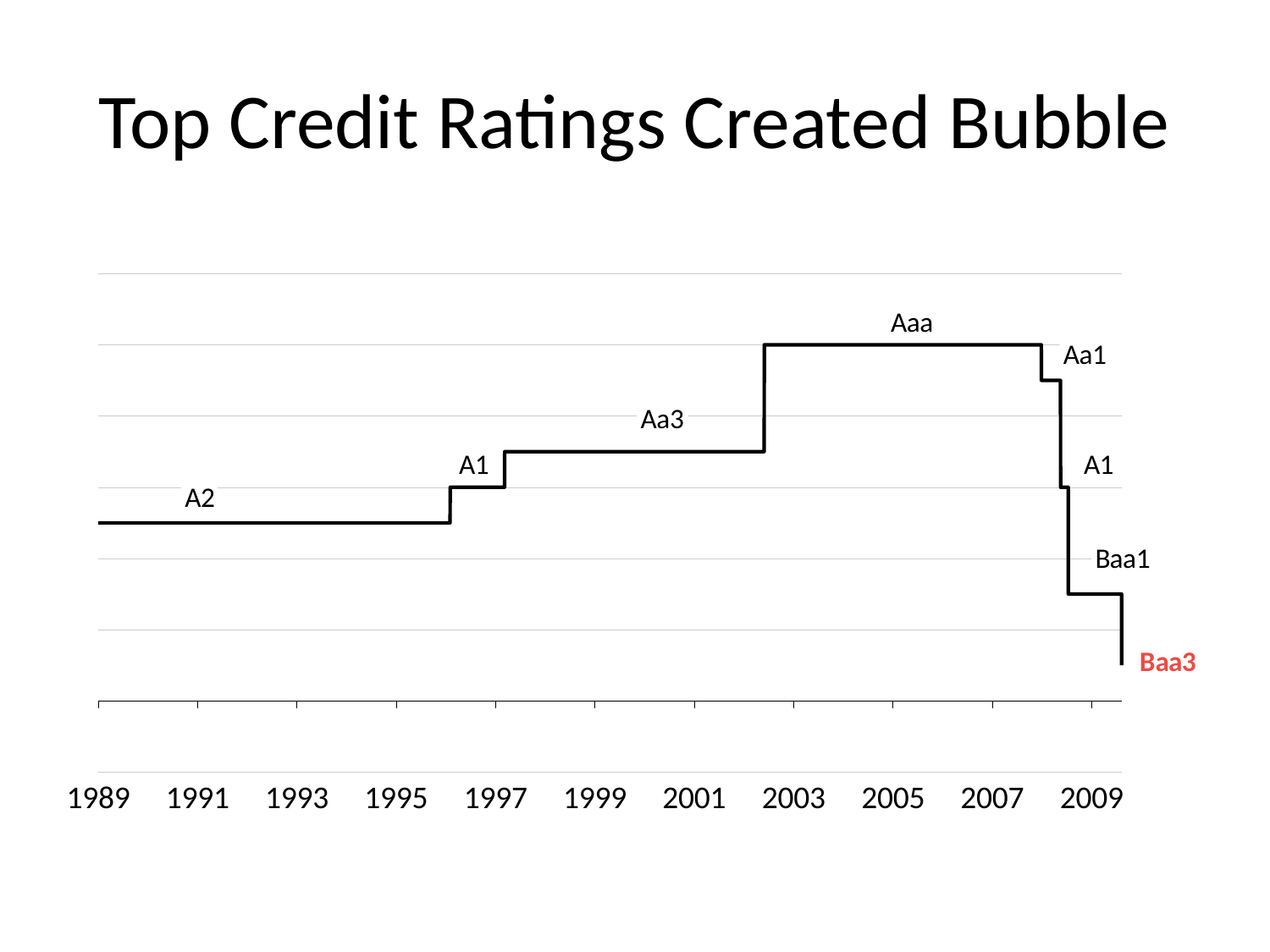
What is the title of the chart? Top Credit Ratings Created Bubble What kind of chart is shown on the slide? line chart Which credit rating label marks the highest point of the line? Aaa Does the line rise or fall between 1989 and 2005? rise What is the first year shown on the x axis? 1989 What credit rating is shown for 2005? Aaa What credit rating is shown for 1989? A2 How many year labels are shown on the x axis? 11 Does the line rise or fall after 2007? fall Which credit rating label marks the lowest point of the line? Baa3 What credit rating is shown for 1999? Aa3 What is the final credit rating shown at the right end of the line? Baa3